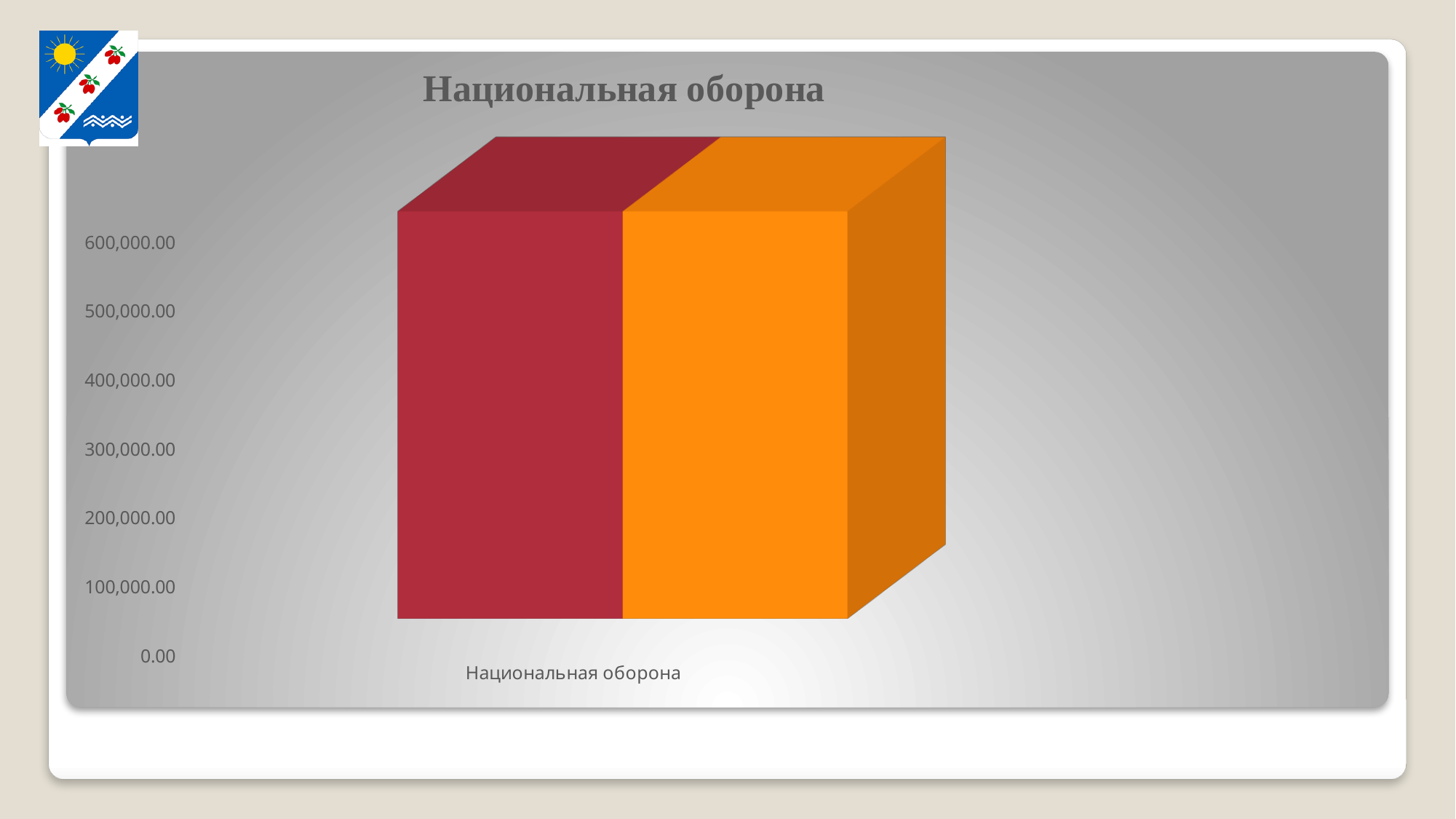
What kind of chart is shown on the slide? bar chart How many bars are plotted in the chart? 2 Is the value of the red bar greater or less than 500,000.00? greater What is the highest tick value shown on the vertical axis? 600,000.00 Is the value of the orange bar greater or less than 500,000.00? greater How many categories are shown on the x axis of the chart? 1 Is the value of the red bar greater or less than 300,000.00? greater What is the title of the chart? Национальная оборона What is the lowest tick value shown on the vertical axis? 0.00 What is the label of the category on the x axis? Национальная оборона